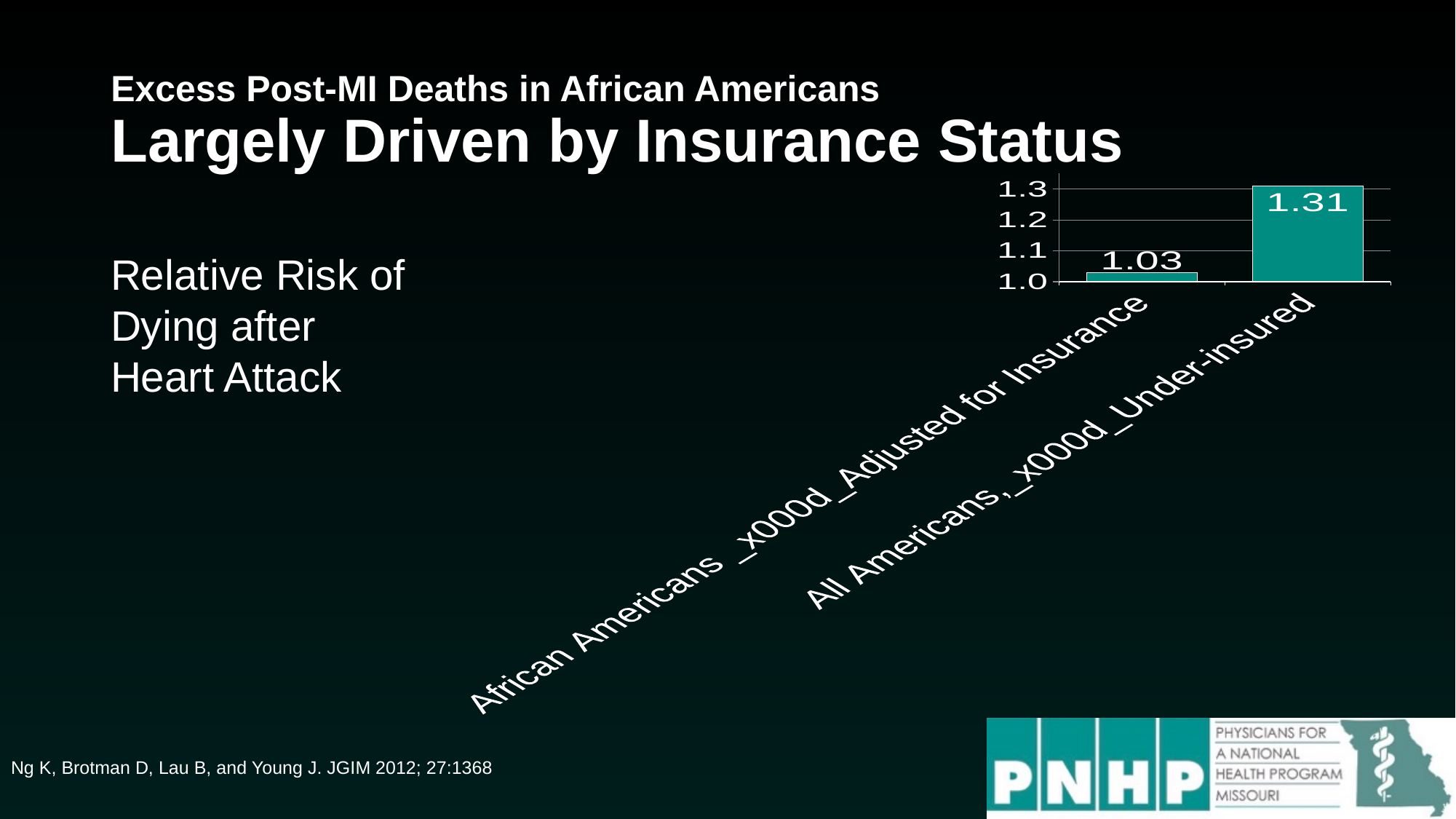
Is the value for African Americans adjusted for insurance greater or less than 1.1? less Is the value for under-insured All Americans greater or less than 1.2? greater Is the relative risk for African Americans adjusted for insurance larger or smaller than that for under-insured All Americans? smaller What kind of chart is shown on the slide? bar chart What is the relative risk value shown for under-insured All Americans? 1.31 What is the relative risk value shown for African Americans adjusted for insurance? 1.03 How many categories (bars) are plotted in the chart? 2 Which category has the higher relative risk of dying after heart attack? All Americans, Under-insured Which category has the lower relative risk of dying after heart attack? African Americans Adjusted for Insurance What quantity does the slide say the chart shows? Relative Risk of Dying after Heart Attack What is the difference between the relative risk for under-insured All Americans and African Americans adjusted for insurance? 0.28 What is the highest tick value shown on the chart's vertical axis? 1.3